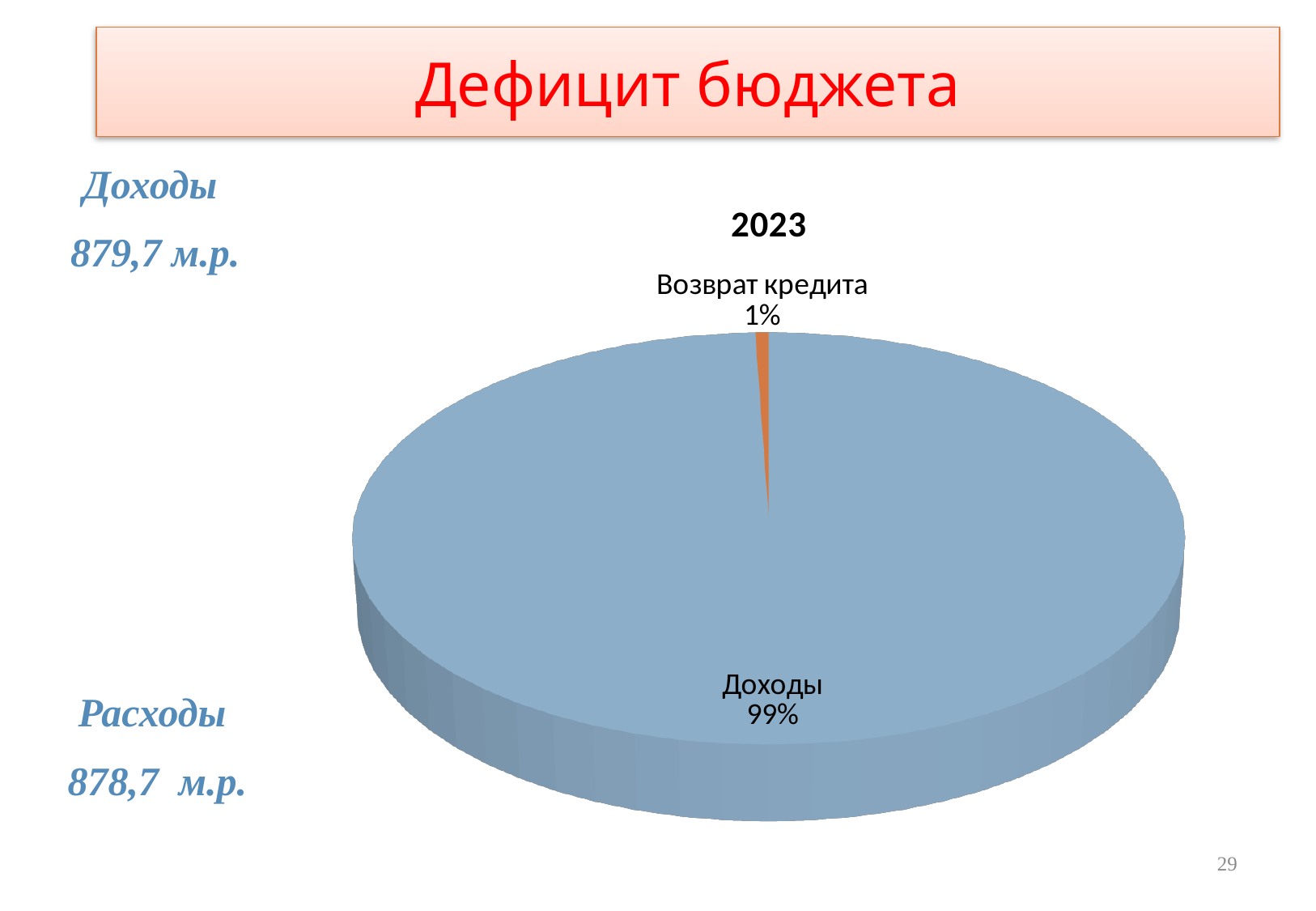
Which slice of the pie is the smallest? Возврат кредита What colour is the Возврат кредита slice? orange Which slice of the pie is the largest? Доходы What is the title of the chart? 2023 How many slices does the pie chart have? 2 What share of the pie does Доходы represent? 99% Which is larger, the Доходы slice or the Возврат кредита slice? Доходы What share of the pie does Возврат кредита represent? 1% What kind of chart is shown on the slide? pie chart What is the difference in percentage points between the Доходы slice and the Возврат кредита slice? 98